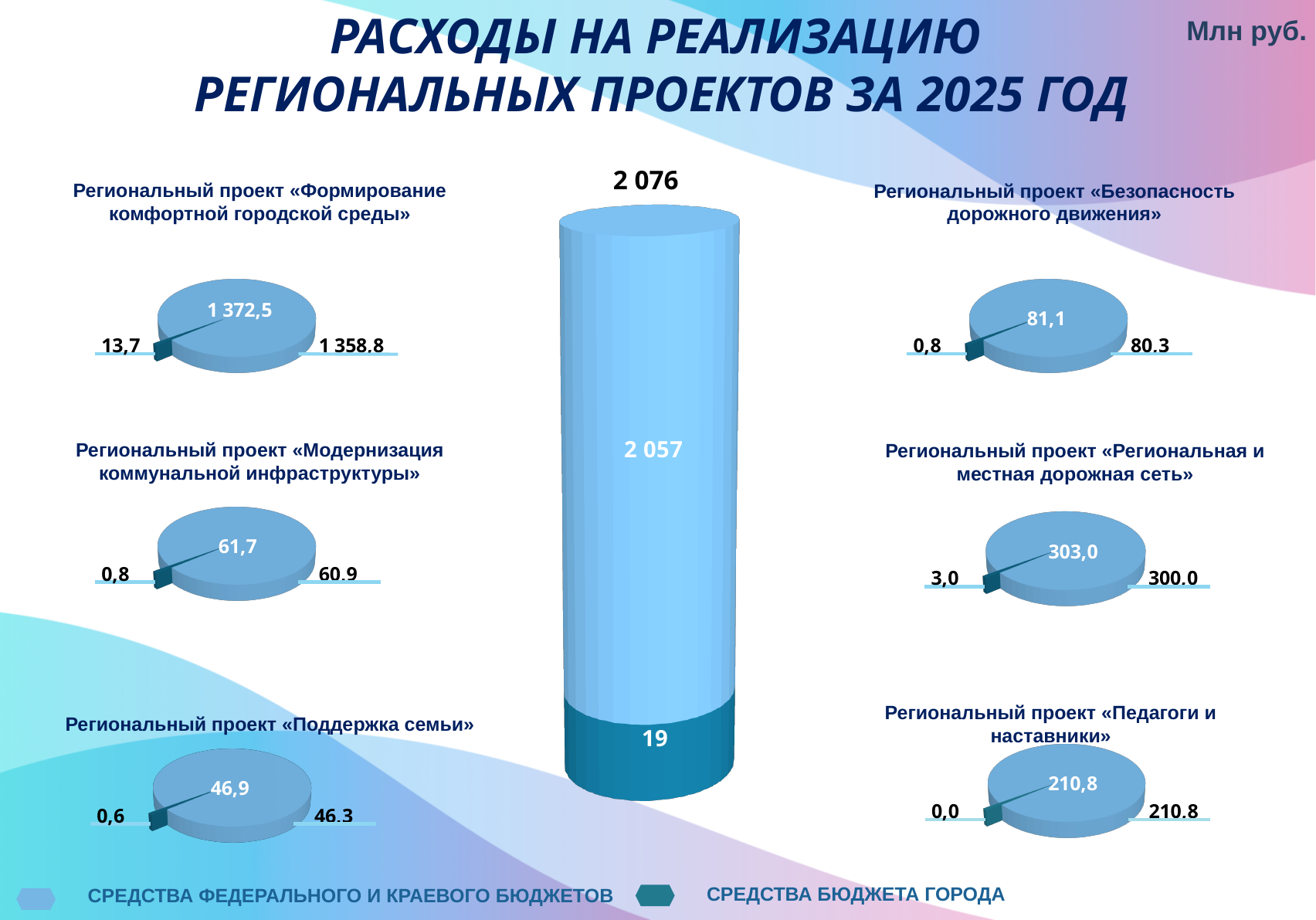
On the central stacked bar chart, which segment is larger: federal and regional budget funds or city budget funds? Federal and regional budget funds How many pie charts are shown on the slide? 6 In the pie chart for the regional project «Педагоги и наставники», what is the value of the federal and regional budget slice? 210.8 How many series does the legend at the bottom of the slide list? 2 In the pie chart for the regional project «Безопасность дорожного движения», what is the total value shown in the centre? 81,1 In the pie chart for the regional project «Региональная и местная дорожная сеть», what is the value of the city budget slice? 3,0 In the pie chart for the regional project «Формирование комфортной городской среды», what is the value of the federal and regional budget slice? 1 358.8 On the central stacked bar chart, what is the total value shown at the top of the bar? 2 076 In the pie chart for the regional project «Формирование комфортной городской среды», what is the value of the city budget slice? 13,7 On the central stacked bar chart, what is the value of the light blue segment (federal and regional budget funds)? 2 057 On the central stacked bar chart, what is the value of the dark teal segment (city budget funds)? 19 On the central stacked bar chart, what is the difference between the federal/regional budget segment and the city budget segment? 2 038